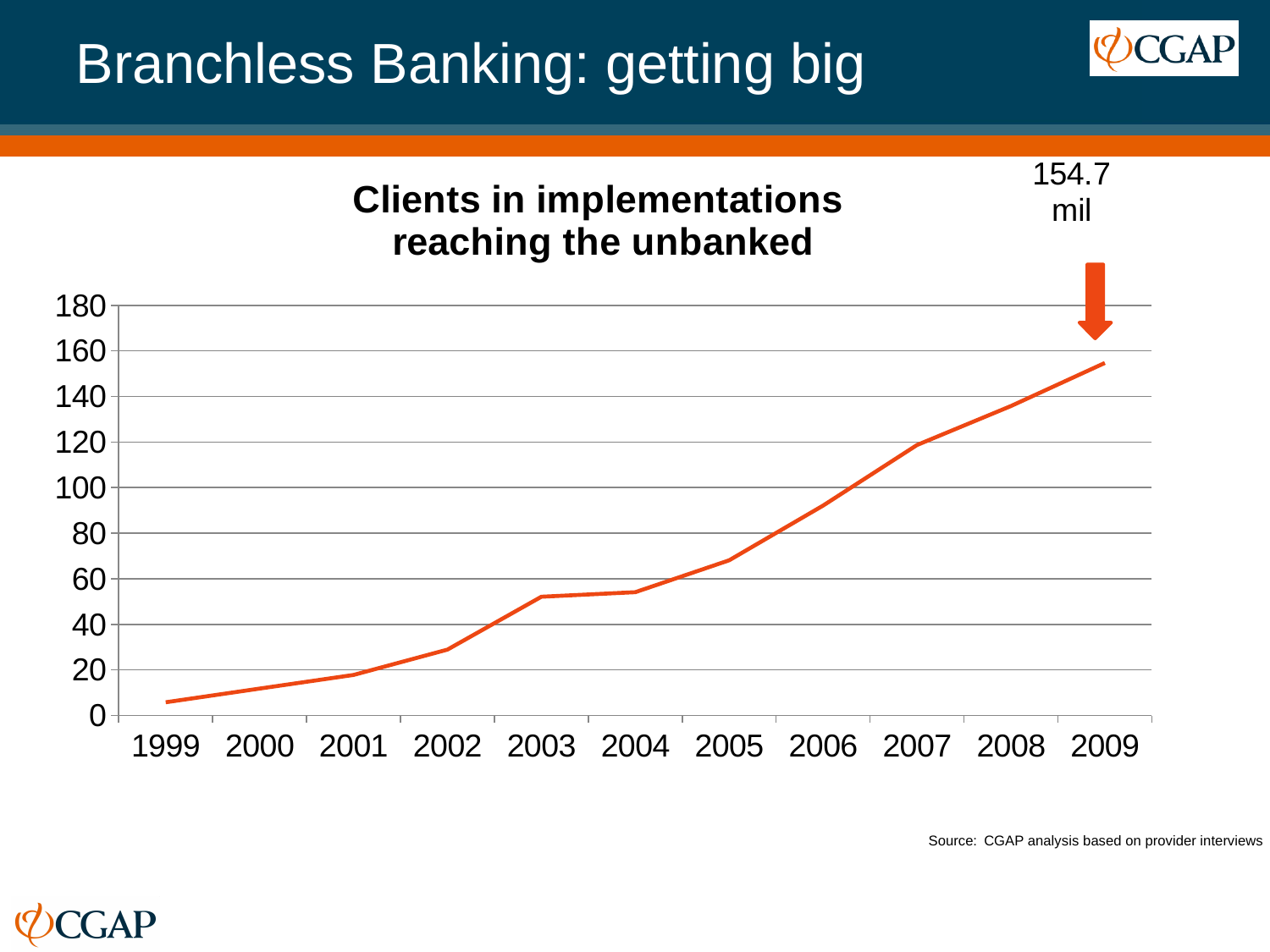
Is the value for 2007 greater or less than 100? greater What value is labelled for 2009 in the chart? 154.7 mil How many years are plotted along the x axis of the chart? 11 Is the value for 2002 greater or less than 40? less Is the value for 2005 greater or less than 80? less What source is cited for the chart? CGAP analysis based on provider interviews What is the title of the chart? Clients in implementations reaching the unbanked Which year has the larger value, 2005 or 2007? 2007 What kind of chart is shown on the slide? line chart Which year has the highest value in the chart? 2009 Do the values in the chart rise or fall from 1999 to 2009? rise Which year has the lowest value in the chart? 1999